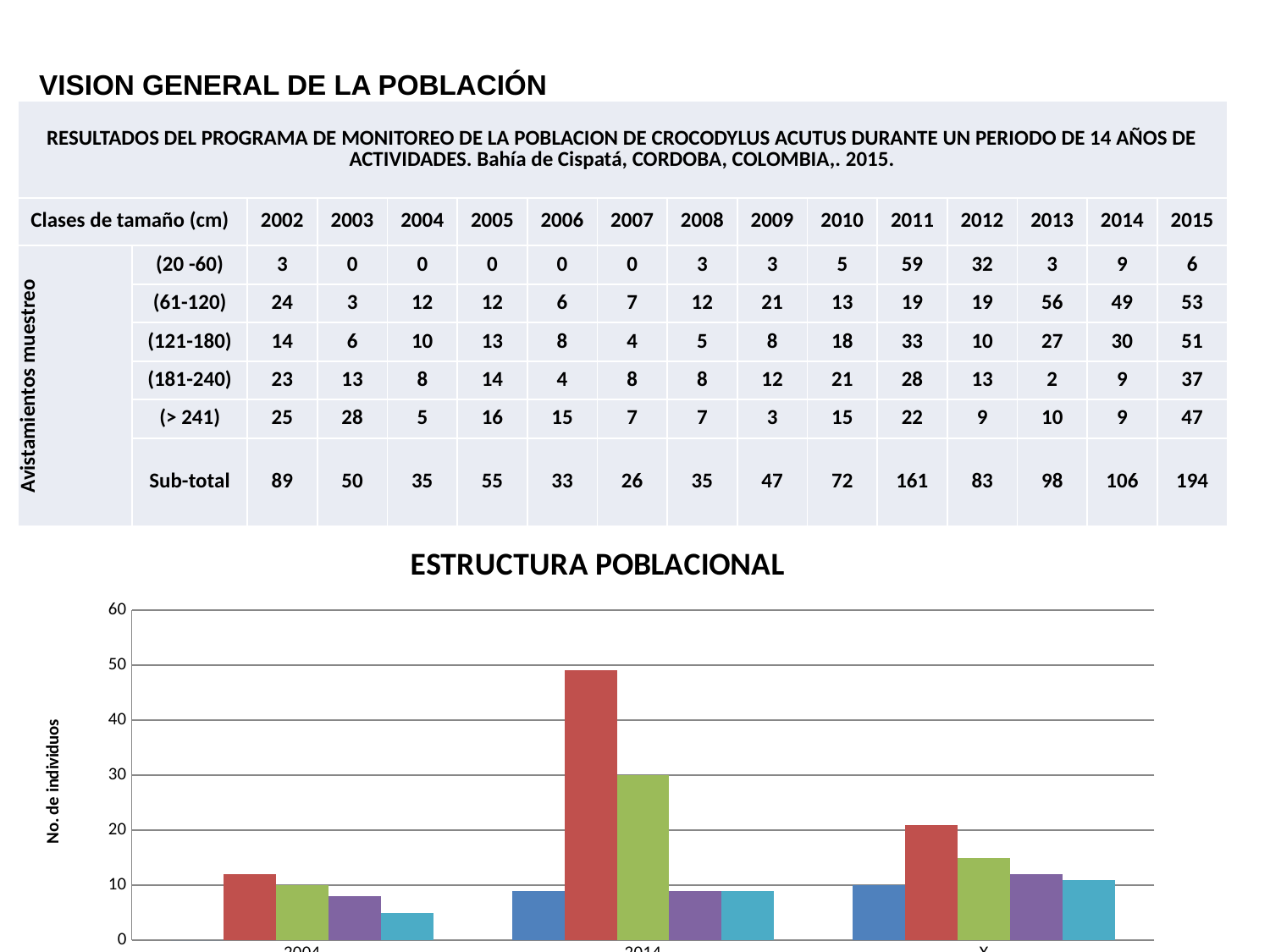
In the ESTRUCTURA POBLACIONAL chart, how many groups of bars are shown along the x axis? 3 In the ESTRUCTURA POBLACIONAL chart, which group contains the tallest bar overall? 2014 In the ESTRUCTURA POBLACIONAL chart, what is the highest value shown on the y axis? 60 In the ESTRUCTURA POBLACIONAL chart, how many bars are in the 2014 group? 5 In the ESTRUCTURA POBLACIONAL chart, how many bars are in the 2004 group? 4 In the ESTRUCTURA POBLACIONAL chart, is the green bar in the 2014 group greater or less than 20? greater What kind of chart is the ESTRUCTURA POBLACIONAL chart? bar chart In the ESTRUCTURA POBLACIONAL chart, is the red bar in the 2004 group greater or less than 20? less What is the y-axis label of the ESTRUCTURA POBLACIONAL chart? No. de individuos In the ESTRUCTURA POBLACIONAL chart, is the tallest bar in the 2014 group greater or less than 40? greater In the ESTRUCTURA POBLACIONAL chart, which is larger: the red bar in the 2004 group or the red bar in the 2014 group? 2014 What is the title of the chart at the bottom of the slide? ESTRUCTURA POBLACIONAL